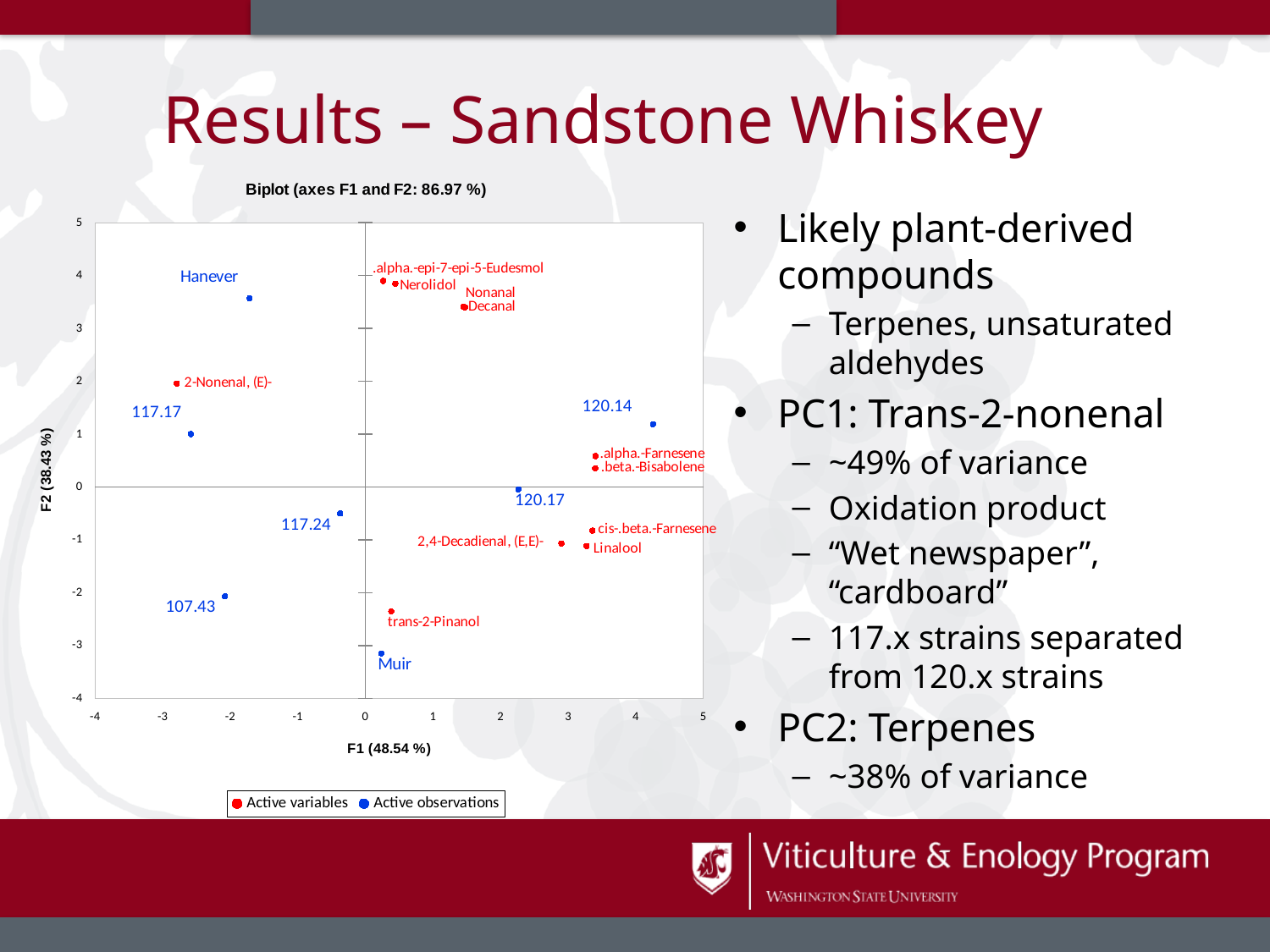
How many series does the chart legend list? 2 Which active observation has the highest F2 value? Hanever Is the F2 value for Muir greater or less than -3? less How many active observation (blue) points are plotted on the chart? 7 What is the label of the horizontal axis of the chart? F1 (48.54 %) What is the title of the chart? Biplot (axes F1 and F2: 86.97 %) What kind of chart is shown on the slide? scatter chart Is the F1 value for 2-Nonenal, (E)- greater or less than -2? less Is the F1 value for 120.14 greater or less than 4? greater Which active observation has the lowest F2 value? Muir Which has the larger F1 value, 120.14 or 117.17? 120.14